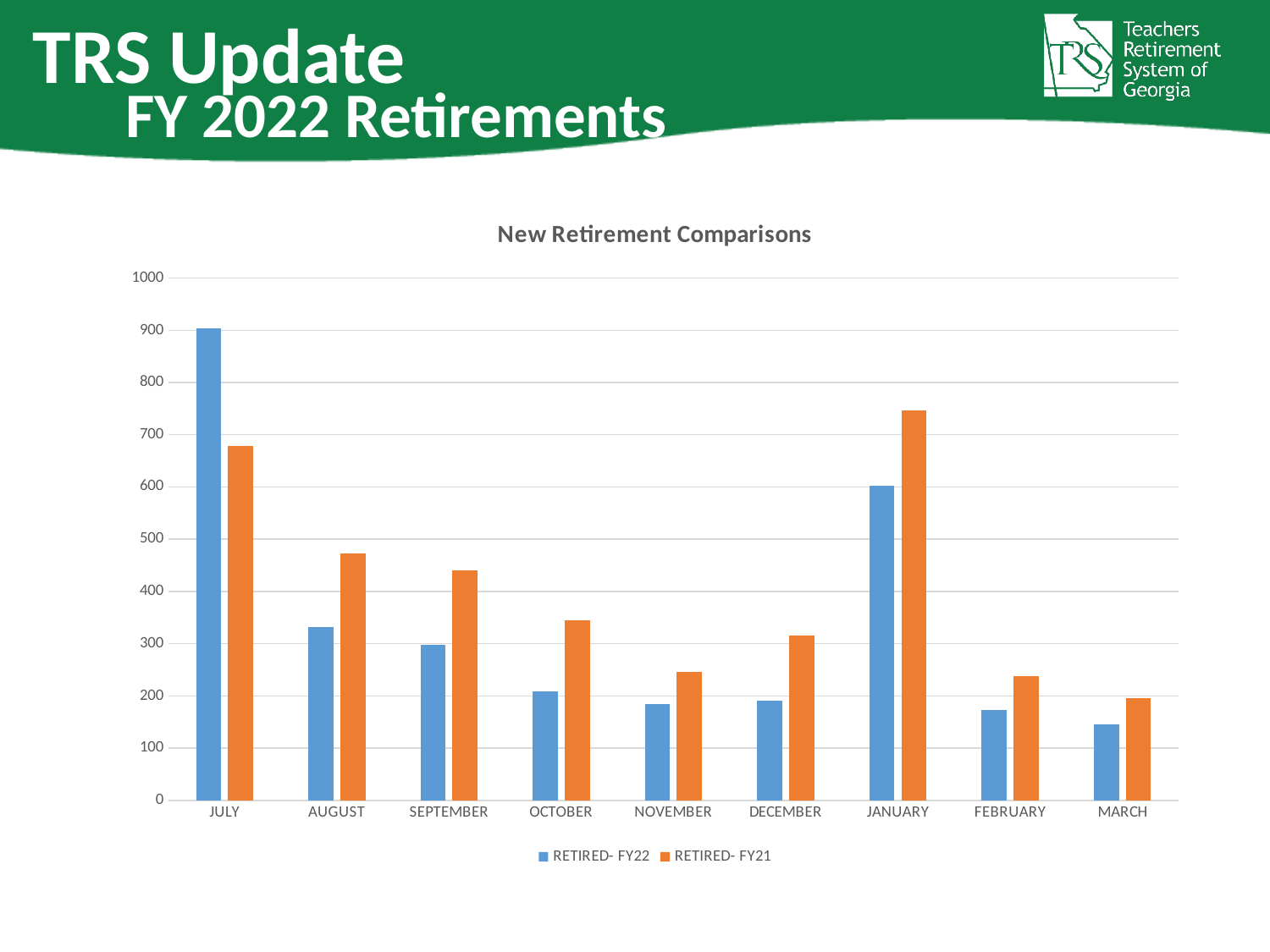
Is the RETIRED- FY21 value for AUGUST greater or less than 500? less How many months are shown on the x axis? 9 Which month has the highest RETIRED- FY21 value? JANUARY Which month has the lowest RETIRED- FY21 value? MARCH In JULY, which is larger: RETIRED- FY22 or RETIRED- FY21? RETIRED- FY22 Is the RETIRED- FY22 value for JULY greater or less than 800? greater What is the title of the chart? New Retirement Comparisons What kind of chart is shown on the slide? bar chart How many series does the legend list? 2 Which month has the lowest RETIRED- FY22 value? MARCH In JANUARY, which is larger: RETIRED- FY22 or RETIRED- FY21? RETIRED- FY21 Which month has the highest RETIRED- FY22 value? JULY